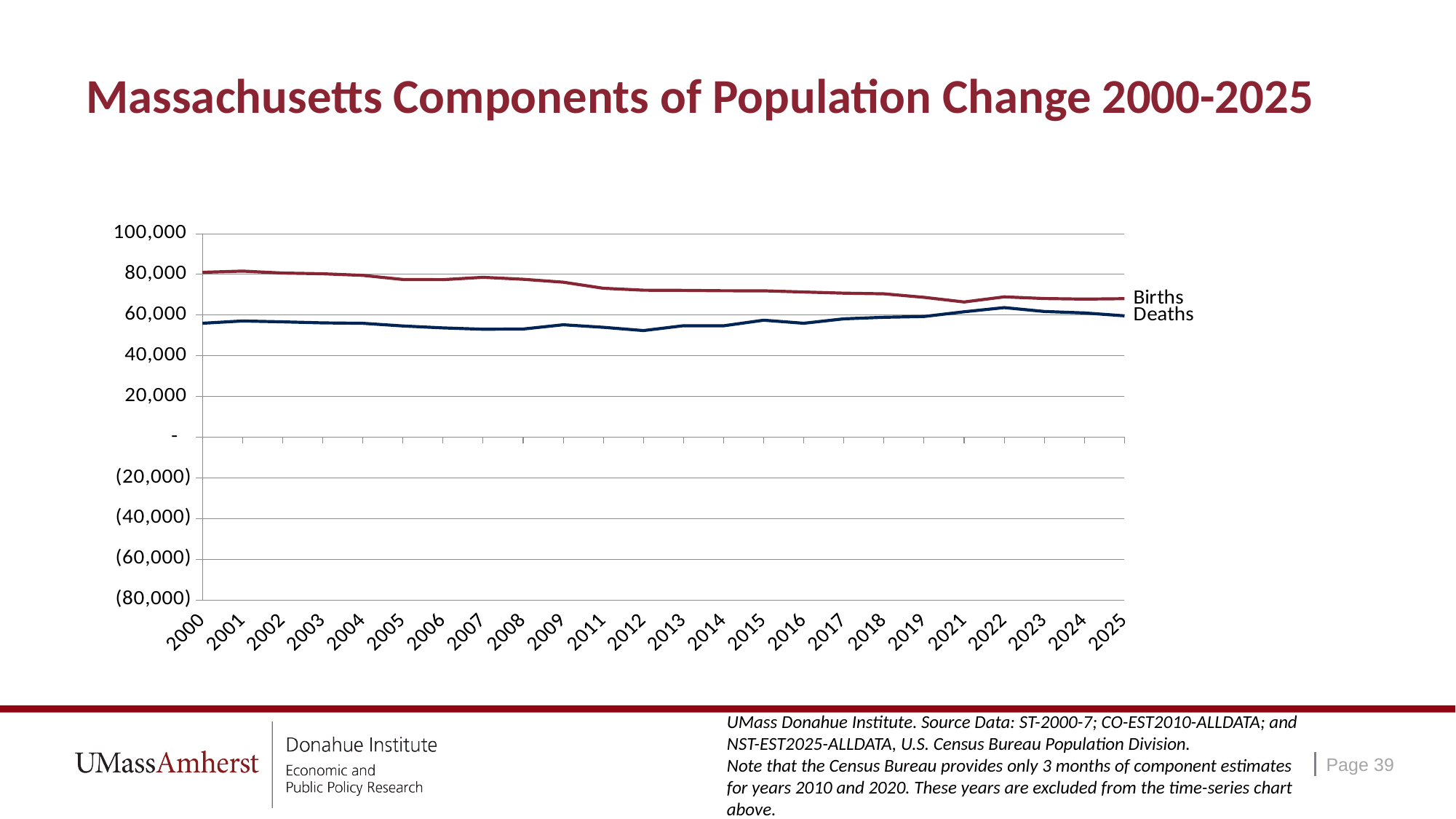
What kind of chart is shown on the slide? Line chart In which year is the Deaths value highest? 2022 Is the Deaths value for 2012 greater or less than 60,000? less In 2000, which is larger, Births or Deaths? Births Do the Births values generally rise or fall from 2000 to 2025? Fall What are the two series plotted on the chart? Births and Deaths Is the Births value for 2021 greater or less than 60,000? greater What is the title of the chart? Massachusetts Components of Population Change 2000-2025 How many years are plotted along the x axis? 24 How many series does the chart show? 2 Is the Births value for 2025 greater or less than 80,000? less Do the Deaths values generally rise or fall from 2000 to 2025? Rise